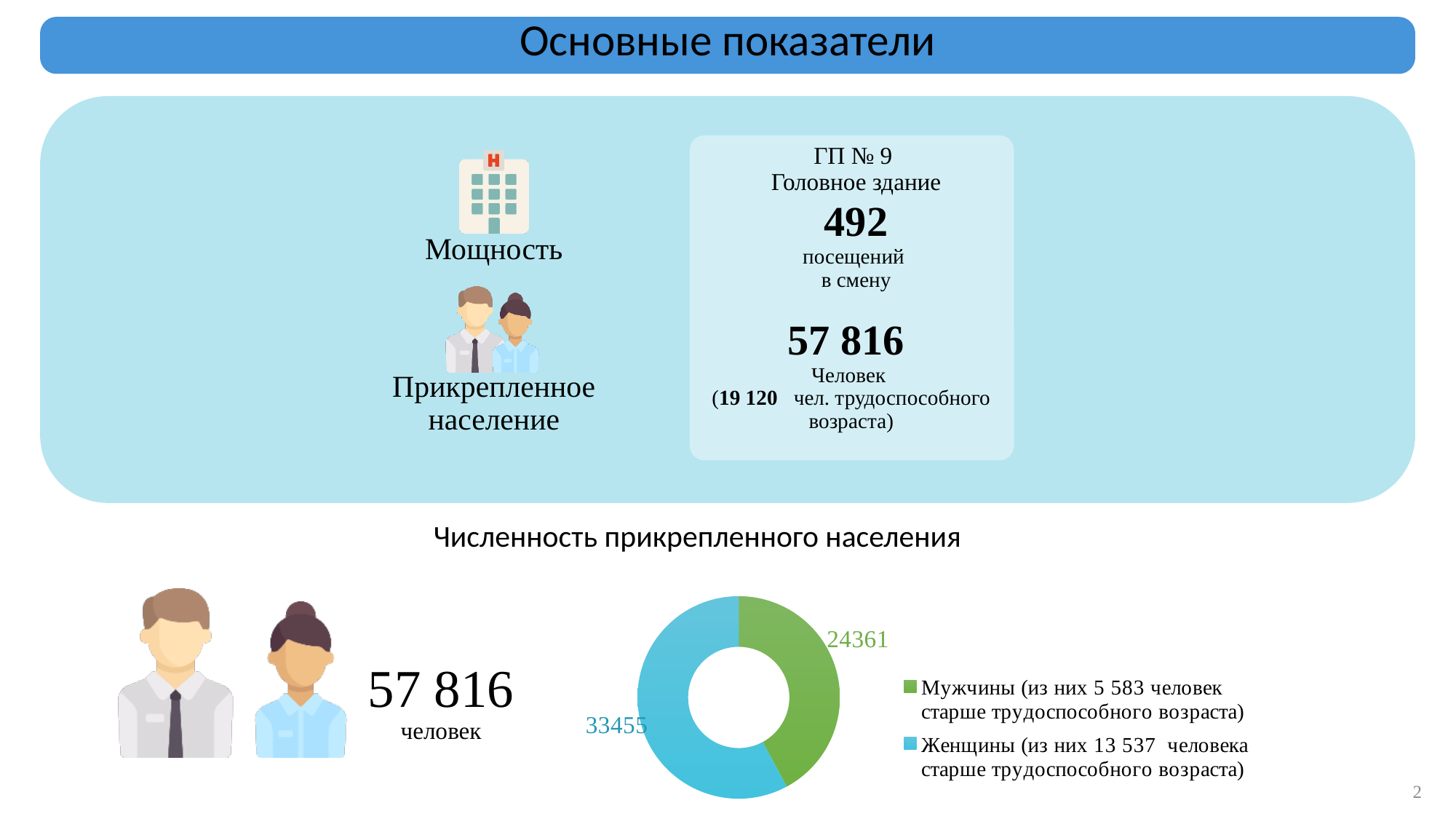
What kind of chart is shown under "Численность прикрепленного населения"? Doughnut (pie) chart What is the total of the two slices in the doughnut chart? 57816 In the doughnut chart, which is larger: Мужчины or Женщины? Женщины What is the title shown above the doughnut chart? Численность прикрепленного населения Which category has the largest slice in the doughnut chart? Женщины How many slices does the doughnut chart have? 2 What is the difference between the Женщины and Мужчины values in the doughnut chart? 9094 What is the value for Мужчины in the doughnut chart? 24361 What is the value for Женщины in the doughnut chart? 33455 What colour is the Мужчины slice in the doughnut chart? Green Which category has the smallest slice in the doughnut chart? Мужчины How many entries does the legend of the doughnut chart list? 2